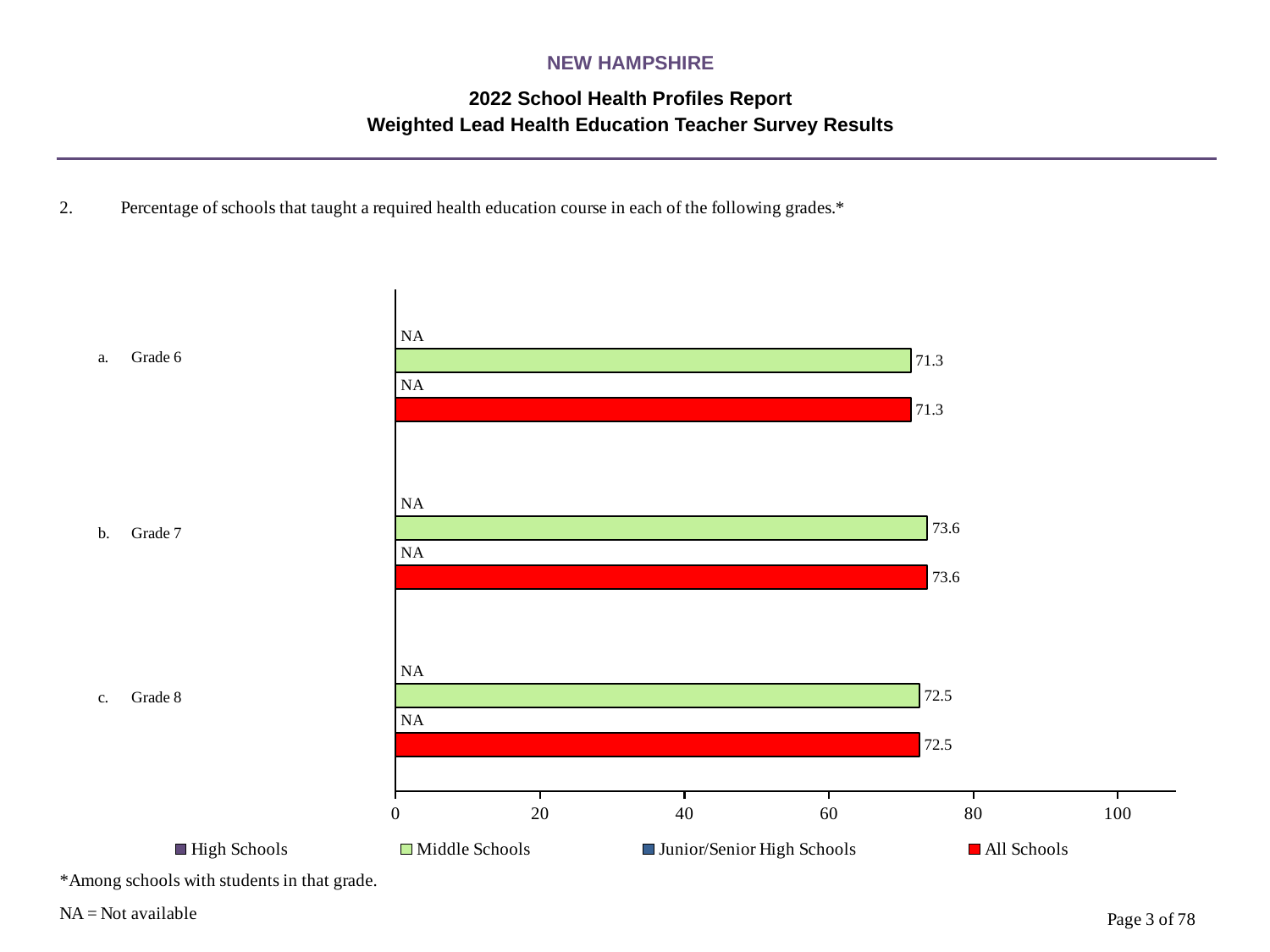
What is the value shown for High Schools in Grade 6? NA Which grade has the highest value for Middle Schools? Grade 7 Which is larger, the All Schools value for Grade 8 or for Grade 6? Grade 8 What kind of chart is shown on the slide? bar chart How many grade categories are shown on the chart? 3 Which grade has the lowest value for All Schools? Grade 6 What is the value for Middle Schools in Grade 8? 72.5 What colour are the All Schools bars? red How many series does the legend list? 4 What is the difference between the Middle Schools values for Grade 7 and Grade 6? 2.3 What is the value for Middle Schools in Grade 7? 73.6 What is the value for All Schools in Grade 6? 71.3